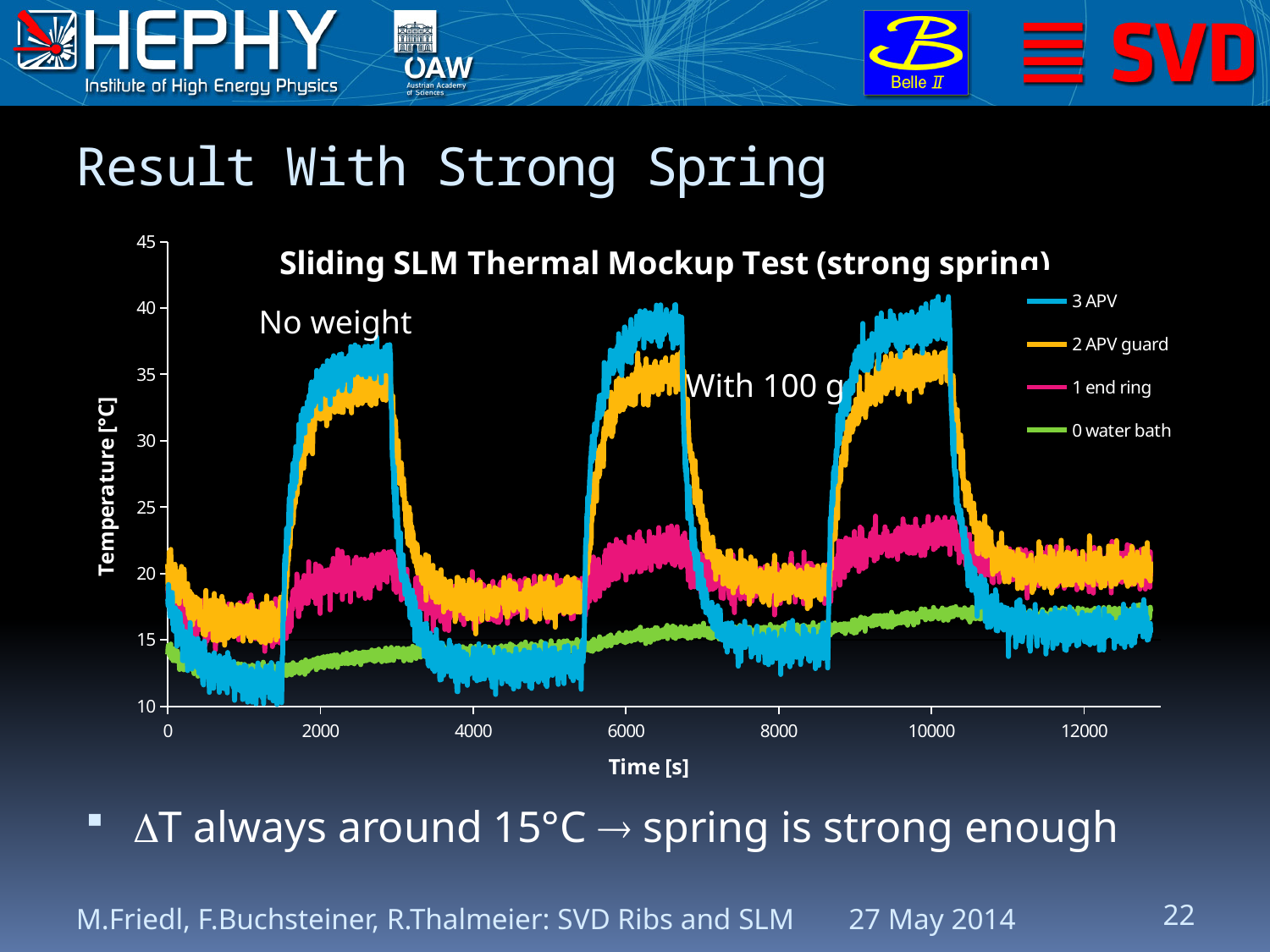
Near 12000 s, which series has the higher temperature, 2 APV guard or 3 APV? 2 APV guard What is the title of the chart? Sliding SLM Thermal Mockup Test (strong spring) How many series does the legend list? 4 Is the peak value of the 3 APV series near 2500 s greater or less than 35? greater Does the 0 water bath series rise or fall over the course of the time axis? rise What is the label of the y axis? Temperature [°C] Which series reaches the highest temperature in the chart? 3 APV Is the value of the 0 water bath series near 10000 s greater or less than 15? greater What kind of chart is shown on the slide? line chart Near 2500 s, which series has the higher temperature, 3 APV or 2 APV guard? 3 APV Is the value of the 3 APV series near 4000 s greater or less than 15? less